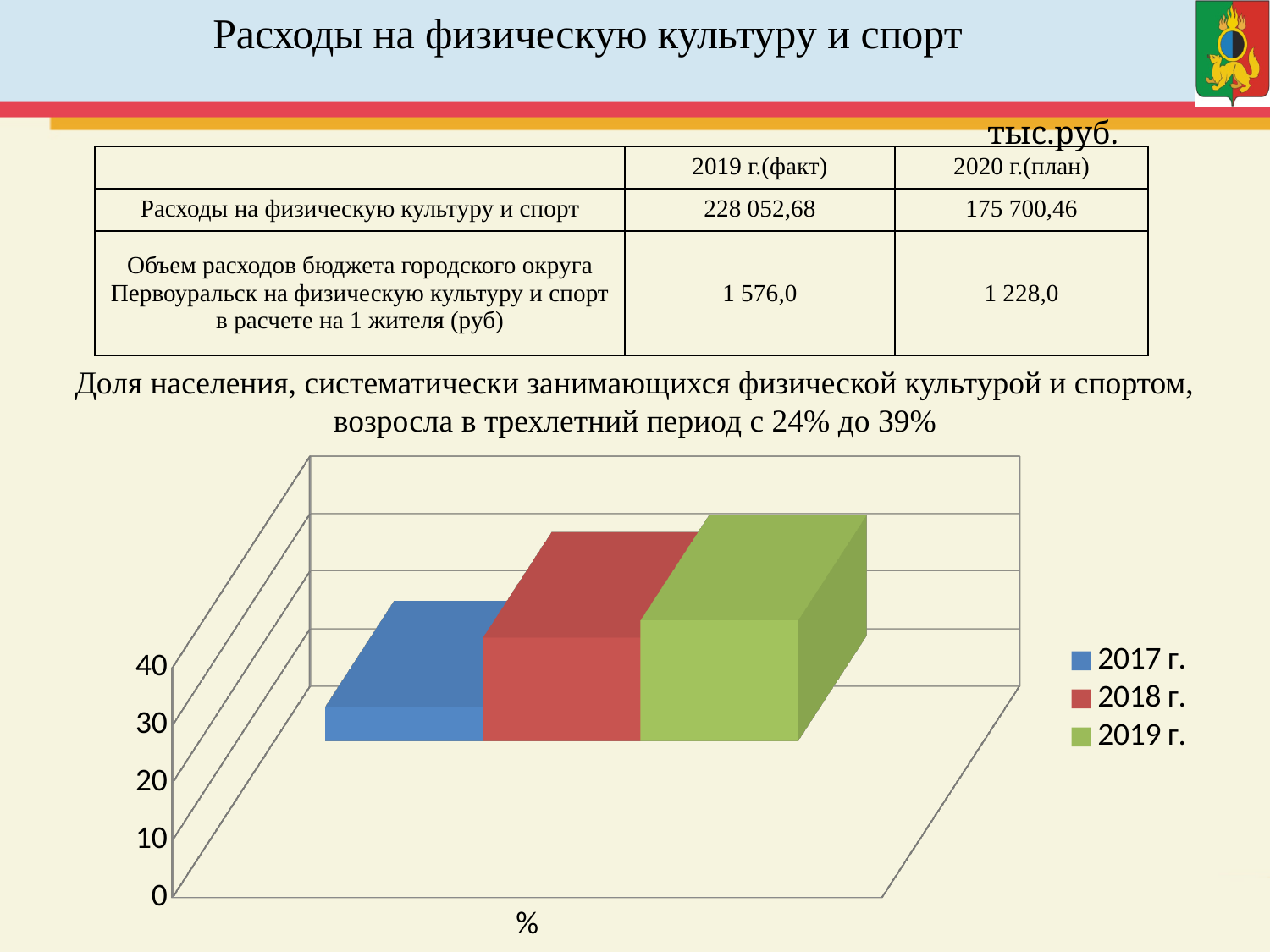
What kind of chart is shown on the slide? bar chart What is the highest tick value shown on the vertical axis of the chart? 40 Is the value for 2017 г. greater or less than 40? less Which bar is taller, 2018 г. or 2017 г.? 2018 г. Which year has the lowest bar in the chart? 2017 г. How many bars are plotted in the chart? 3 Do the bar values rise or fall from 2017 г. to 2019 г.? rise How many series does the chart legend list? 3 What colour is the bar for 2019 г. in the chart? green Which year has the highest bar in the chart? 2019 г. Is the value for 2019 г. greater or less than 20? greater